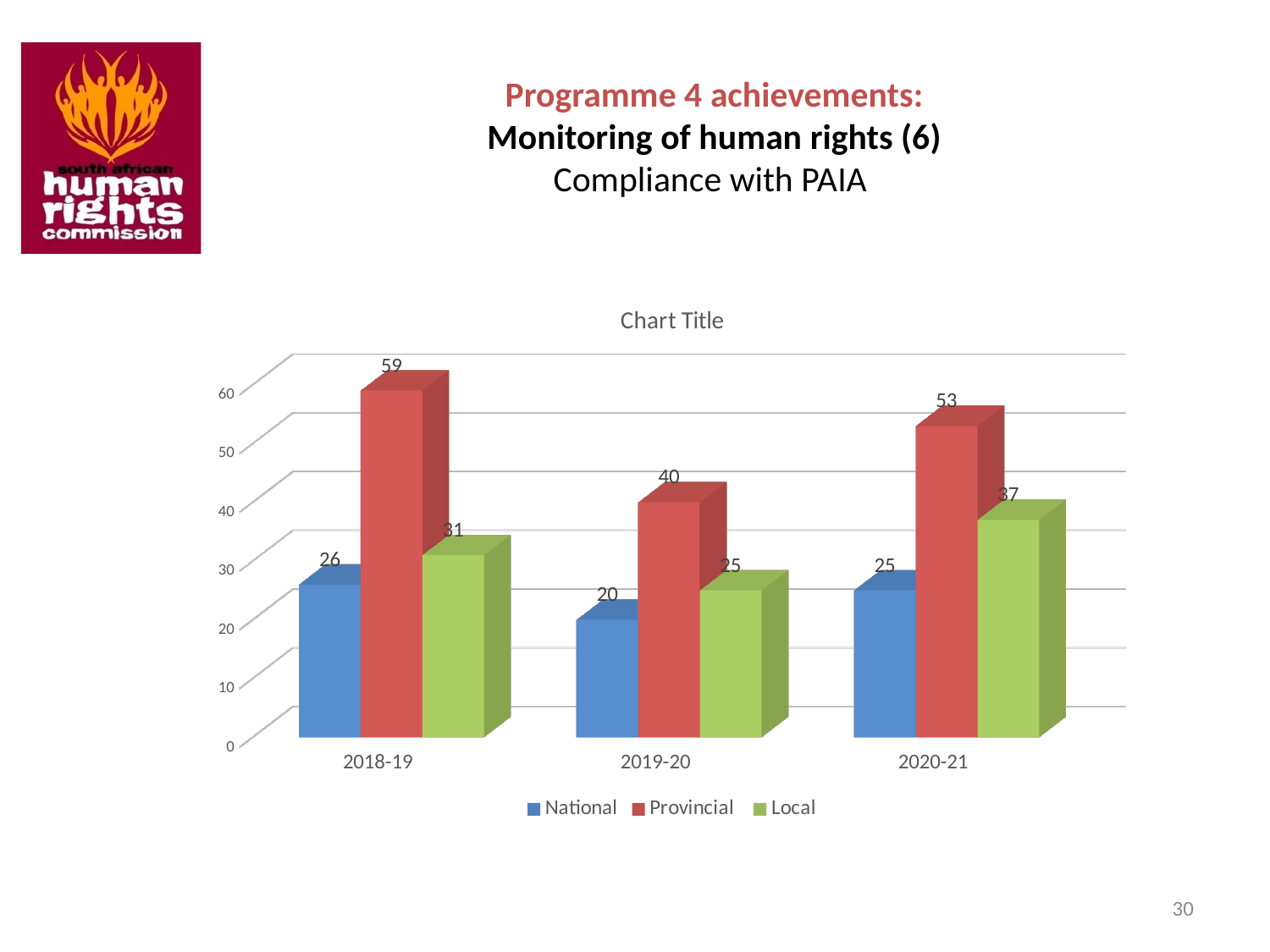
Which year has the lowest National value? 2019-20 What is the value for Provincial in 2018-19? 59 What is the value for Local in 2020-21? 37 What is the value for National in 2019-20? 20 How many series does the legend list? 3 What kind of chart is shown? Bar chart Which year has the highest Provincial value? 2018-19 Is the value for Provincial in 2019-20 greater or less than 30? greater Which is larger in 2019-20, the Local value or the National value? Local Which colour represents the Local series? Green How many years are shown on the x axis? 3 What is the difference between the Provincial and National values in 2020-21? 28